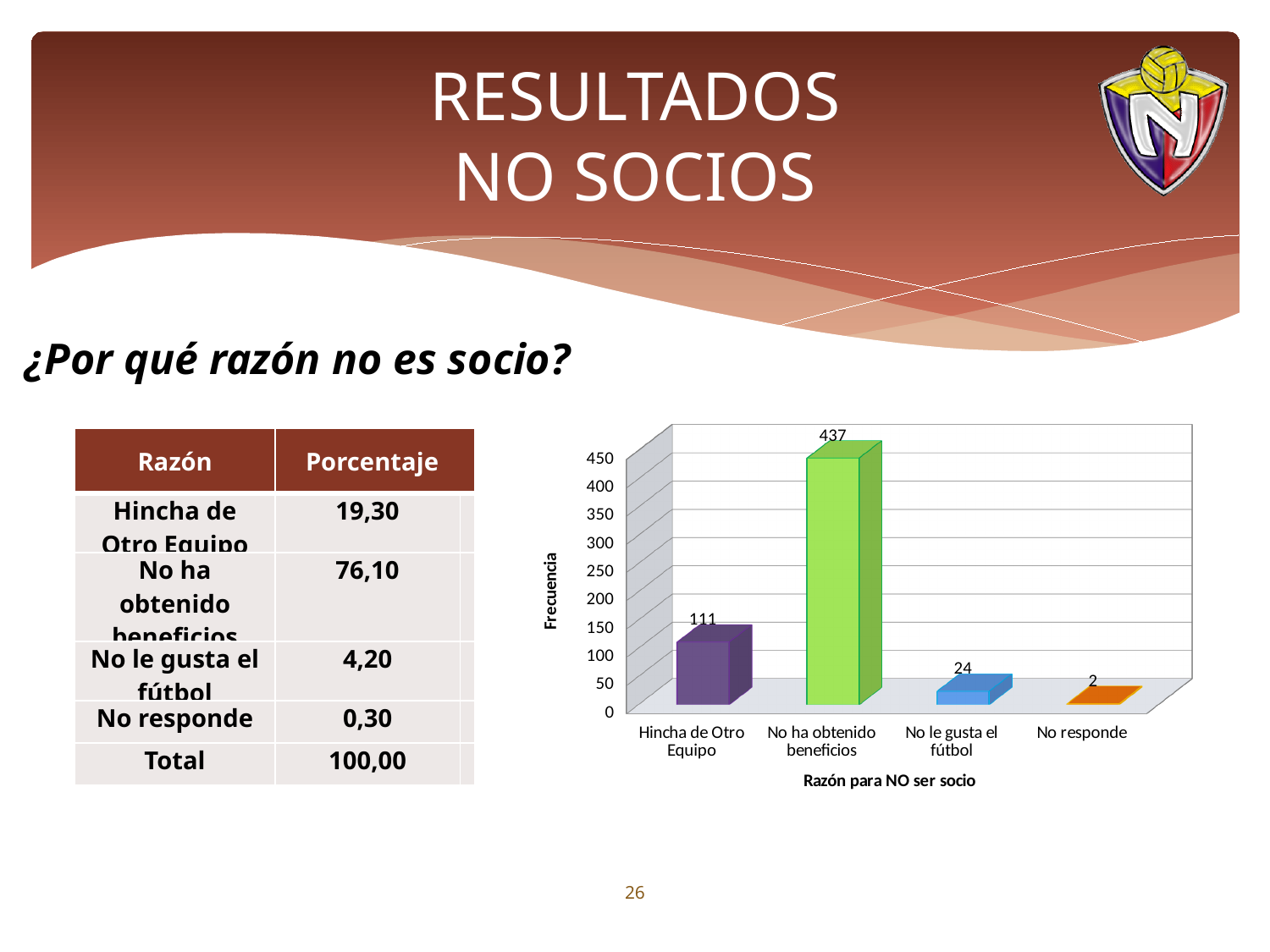
How many categories are shown on the x axis of the chart? 4 What is the frequency for 'No responde'? 2 What is the frequency for 'No le gusta el fútbol'? 24 Which has a higher frequency, 'Hincha de Otro Equipo' or 'No le gusta el fútbol'? Hincha de Otro Equipo What is the frequency for 'Hincha de Otro Equipo'? 111 What is the title of the chart's x axis? Razón para NO ser socio Which reason has the lowest frequency? No responde Which reason has the highest frequency? No ha obtenido beneficios What kind of chart is shown on the slide? Bar chart What is the difference in frequency between 'No ha obtenido beneficios' and 'Hincha de Otro Equipo'? 326 What is the difference in frequency between 'No le gusta el fútbol' and 'No responde'? 22 What is the frequency for 'No ha obtenido beneficios'? 437